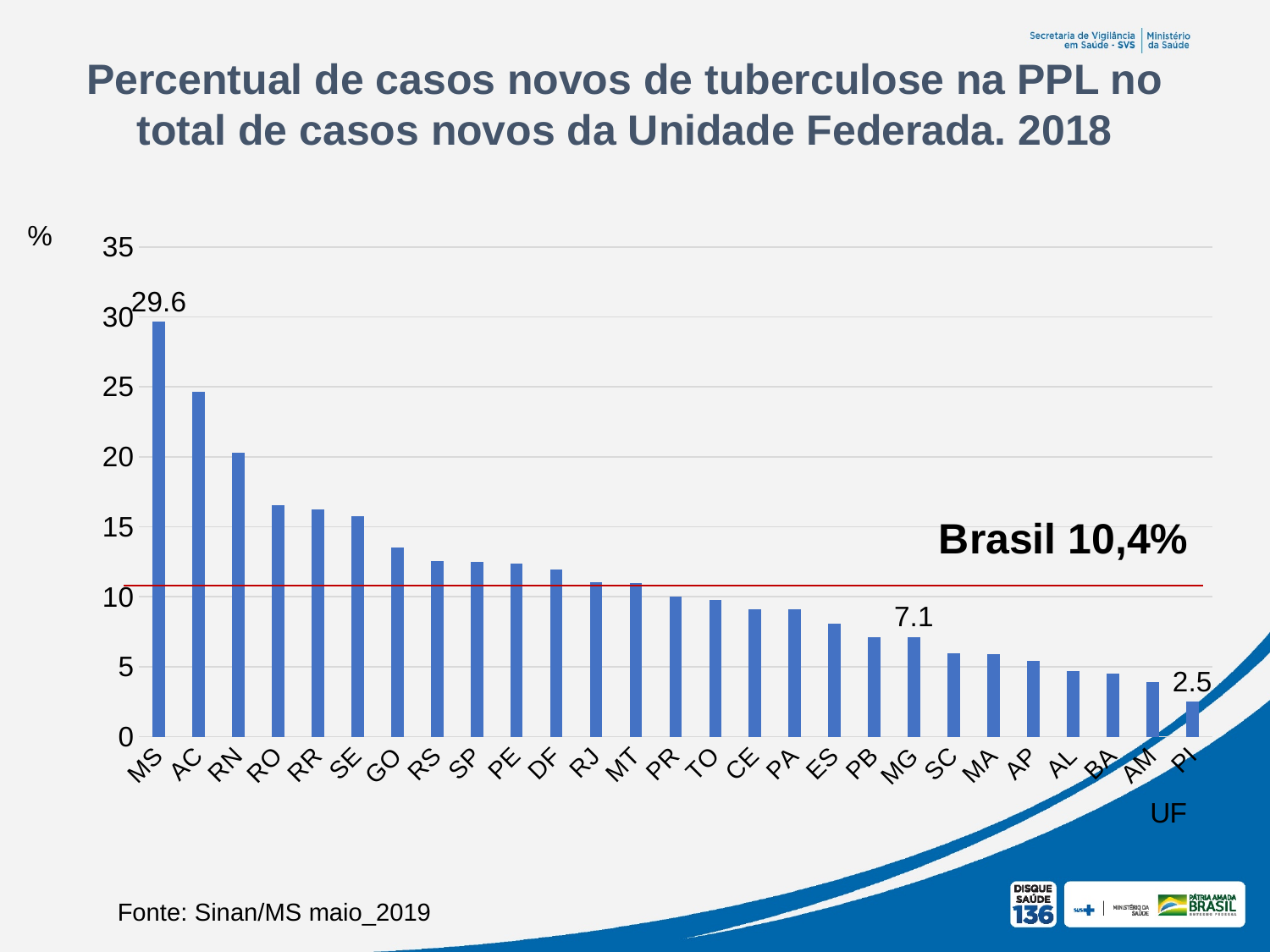
Is the value for RO greater or less than 15? greater What is the value for MS? 29.6 Which is larger, the value for AC or the value for RN? AC Is the value for CE greater or less than 10? less Which UF has the lowest percentage? PI What is the difference between the values for MS and PI? 27.1 What is the value for MG? 7.1 What kind of chart is shown on the slide? bar chart How many UFs are shown on the x axis? 27 What is the difference between the values for MS and MG? 22.5 What is the value for PI? 2.5 Which UF has the highest percentage? MS